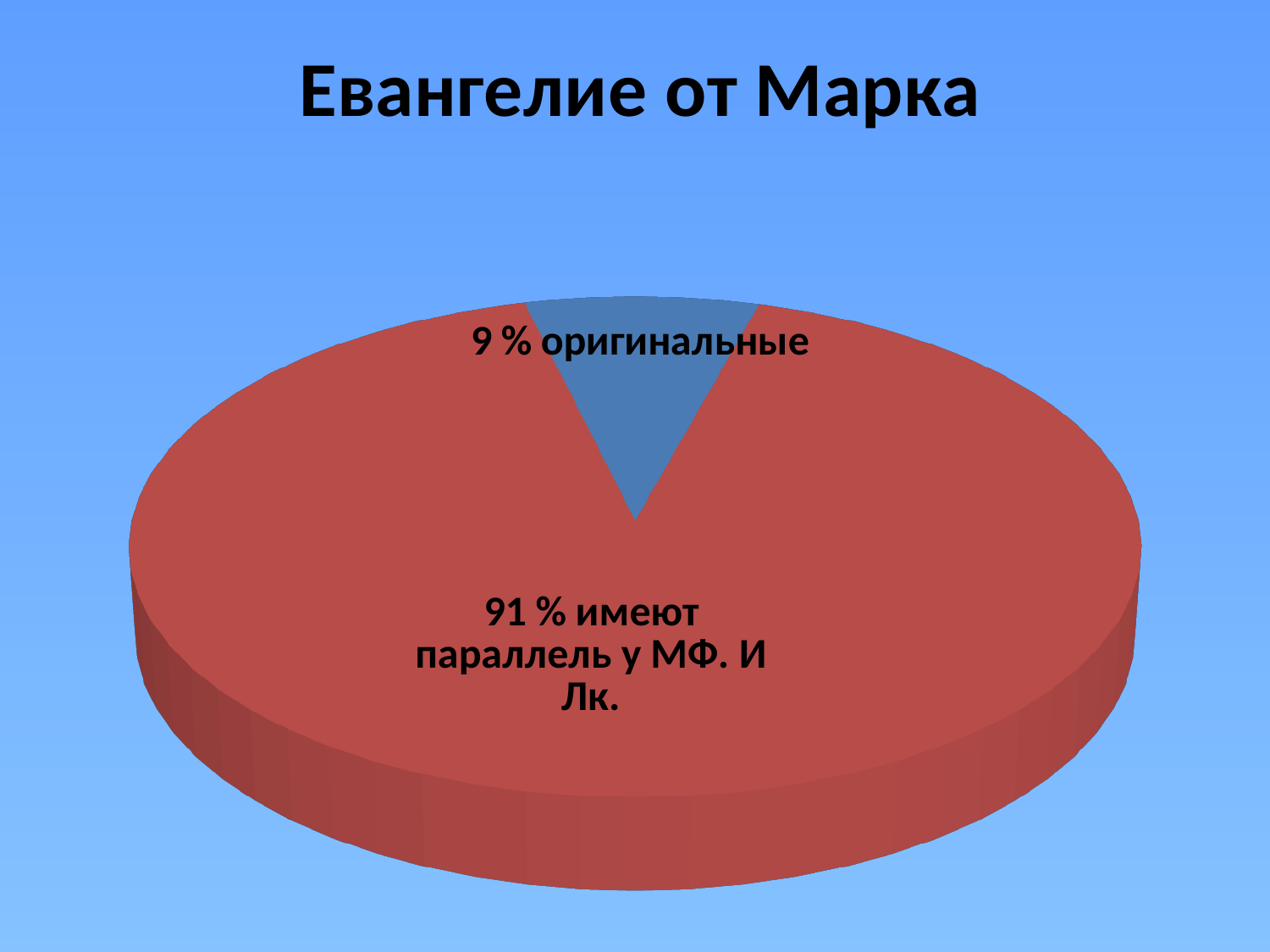
What is the title of the chart? Евангелие от Марка What share of the pie is labelled "имеют параллель у МФ. И Лк."? 91 % Which is larger: the "оригинальные" slice or the "имеют параллель у МФ. И Лк." slice? имеют параллель у МФ. И Лк. What share of the pie is labelled "оригинальные"? 9 % Which slice is the largest? 91 % имеют параллель у МФ. И Лк. What kind of chart is shown on the slide? pie chart What is the difference in percentage points between the two slices? 82 Which slice is the smallest? 9 % оригинальные What colour is the "оригинальные" slice? blue How many slices does the pie chart have? 2 What is the total of the two slices' percentages? 100 %